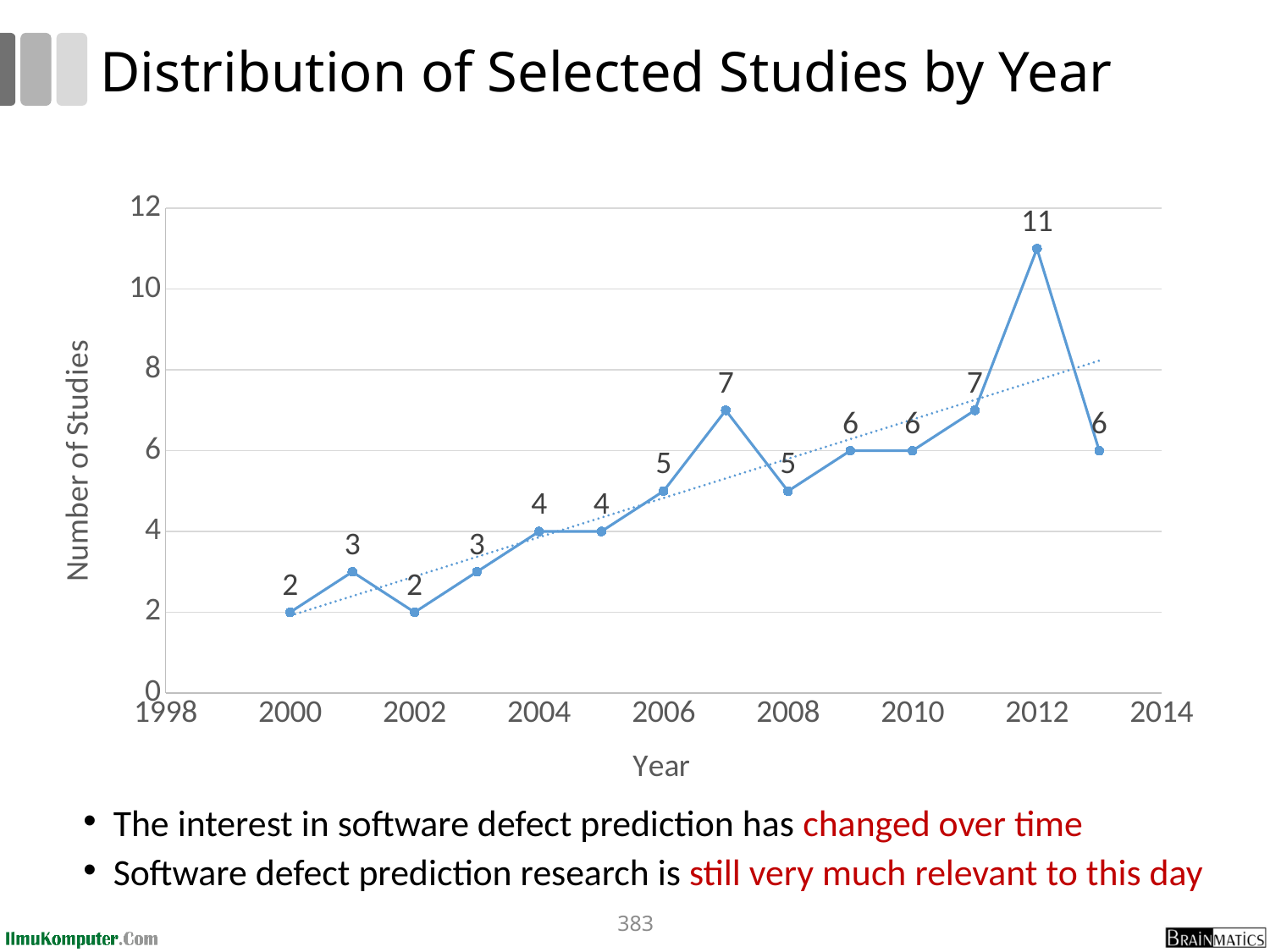
How many studies were selected in 2012? 11 What is the difference in the number of studies between 2012 and 2013? 5 Which year has the highest number of studies? 2012 Which year has more studies, 2008 or 2009? 2009 What is the label of the y-axis? Number of Studies What is the difference in the number of studies between 2004 and 2000? 2 What is the overall trend in the number of studies from 2000 to 2013? rising What is the title of the chart? Distribution of Selected Studies by Year What is the number of studies for the year 2000? 2 What type of chart is shown on the slide? line chart How many data points are plotted on the line? 14 How many studies are plotted for 2007? 7